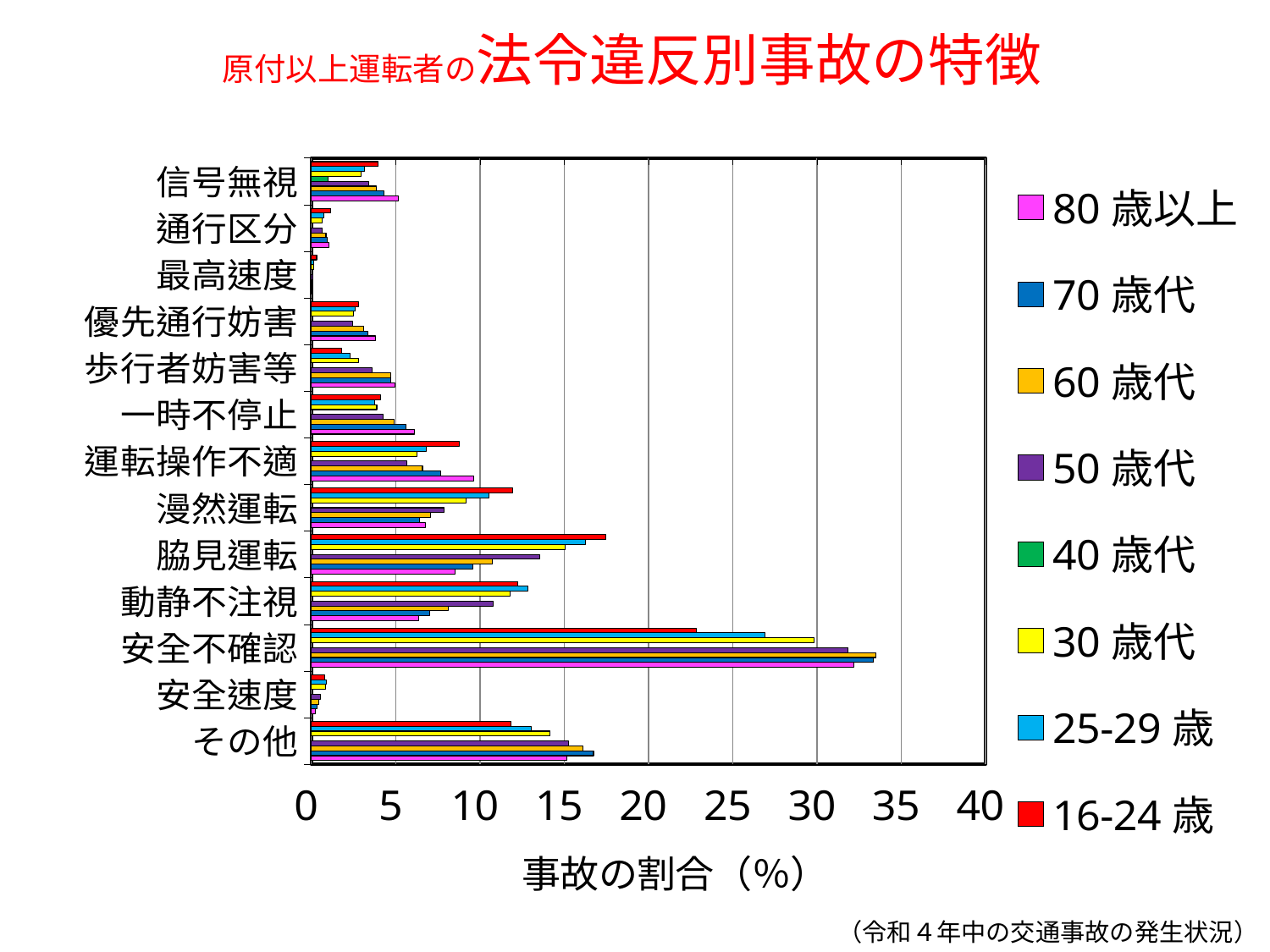
Which violation category has the lowest accident share across the age groups? 最高速度 Is the value for 信号無視 in the 80 歳以上 series greater or less than 10? less How many age-group series does the legend list? 8 How many violation categories are listed on the vertical axis of the chart? 13 Is the value for 脇見運転 in the 16-24 歳 series greater or less than 15? greater For the 16-24 歳 series, which is larger: the value for 安全不確認 or the value for 脇見運転? 安全不確認 What is the label of the horizontal axis of the chart? 事故の割合（%） Which violation category has the highest accident share across the age groups? 安全不確認 Is the value for 安全不確認 in the 16-24 歳 series greater or less than 20? greater For 脇見運転, which age group has the larger value: 16-24 歳 or 80 歳以上? 16-24 歳 What kind of chart is shown on the slide? Bar chart